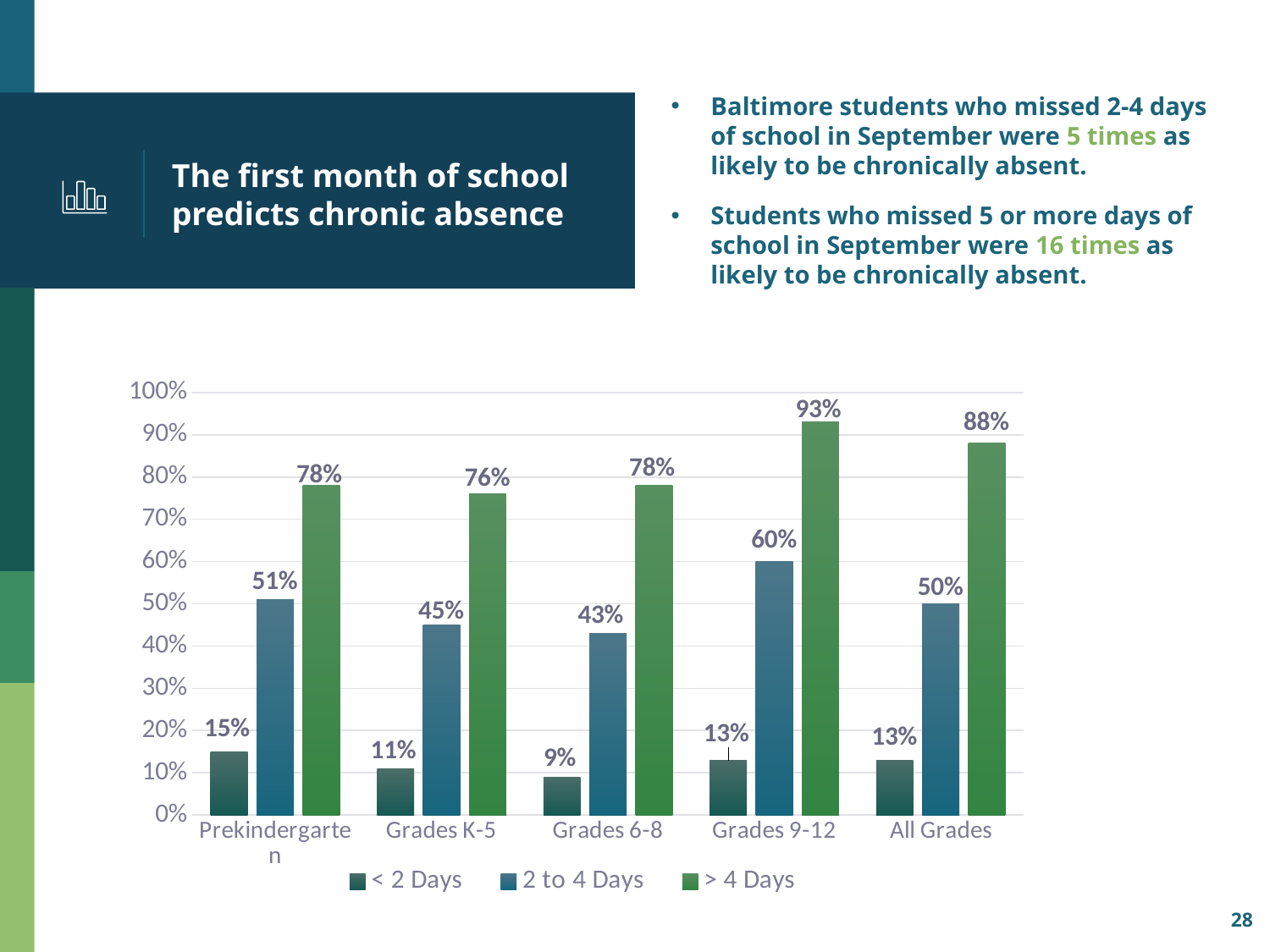
Which grade group has the highest value in the > 4 Days series? Grades 9-12 How many grade categories are shown on the x axis? 5 What kind of chart is shown on the slide? Bar chart What is the difference between the 2 to 4 Days values for Grades 9-12 and Grades 6-8? 17% Which is larger for Grades K-5: the 2 to 4 Days value or the > 4 Days value? > 4 Days What is the difference between the > 4 Days and < 2 Days values for All Grades? 75% What is the value for Prekindergarten in the 2 to 4 Days series? 51% What is the title of the slide containing the chart? The first month of school predicts chronic absence What is the value for Grades 9-12 in the > 4 Days series? 93% Which grade group has the lowest value in the < 2 Days series? Grades 6-8 What is the value for Grades 6-8 in the < 2 Days series? 9% How many series does the legend list? 3